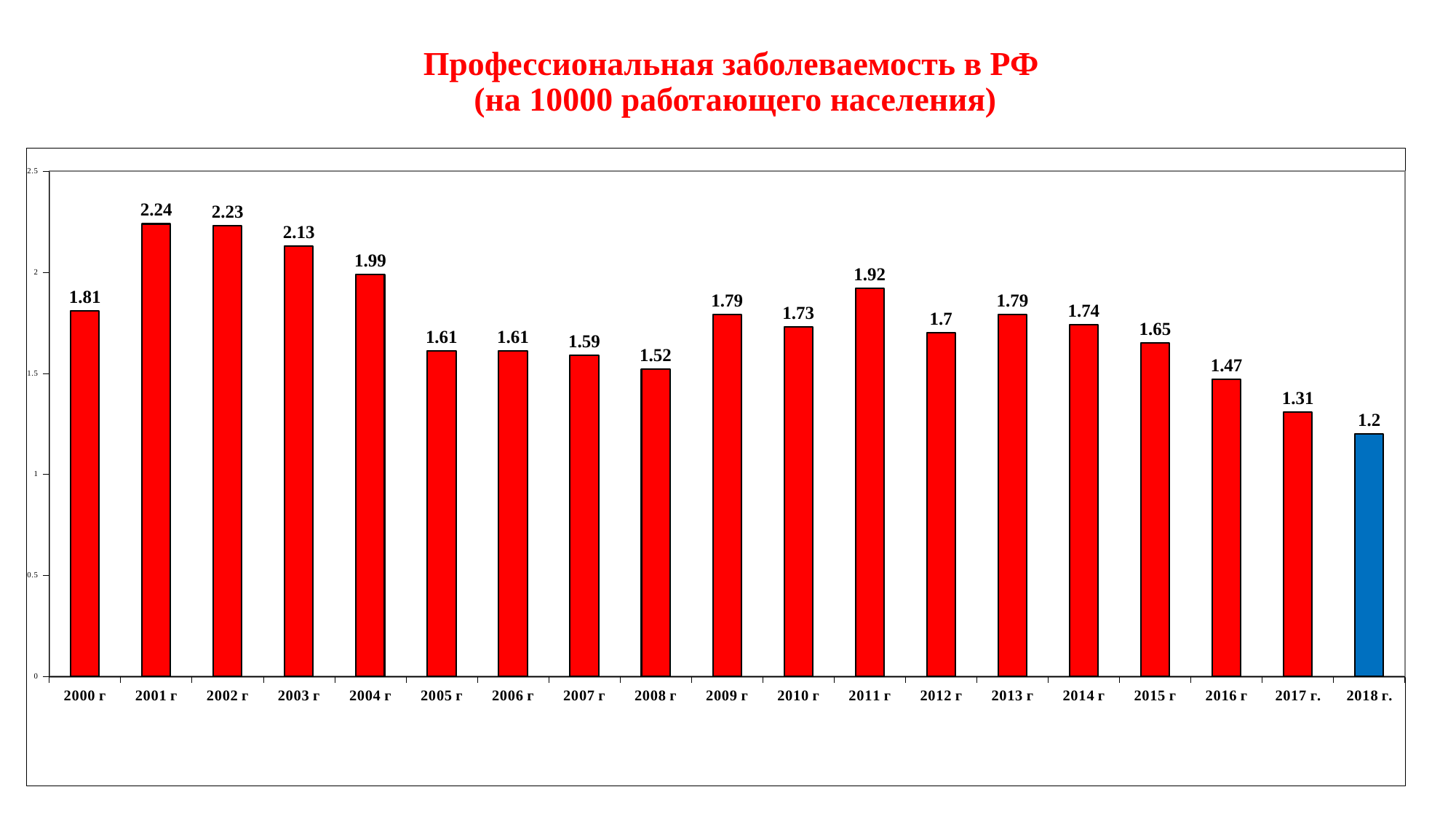
What is the value for 2011 г? 1.92 What is the difference between the values for 2011 г and 2012 г? 0.22 Which year has the lowest value? 2018 г. What is the value for 2018 г.? 1.2 How many years are shown on the x axis? 19 Which is larger, the value for 2009 г or the value for 2010 г? 2009 г Which year has the highest value? 2001 г What kind of chart is shown on the slide? bar chart What colour is the bar for 2018 г.? blue Is the value for 2017 г. greater or less than 1.5? less What is the difference between the values for 2001 г and 2018 г.? 1.04 What is the value for 2000 г? 1.81